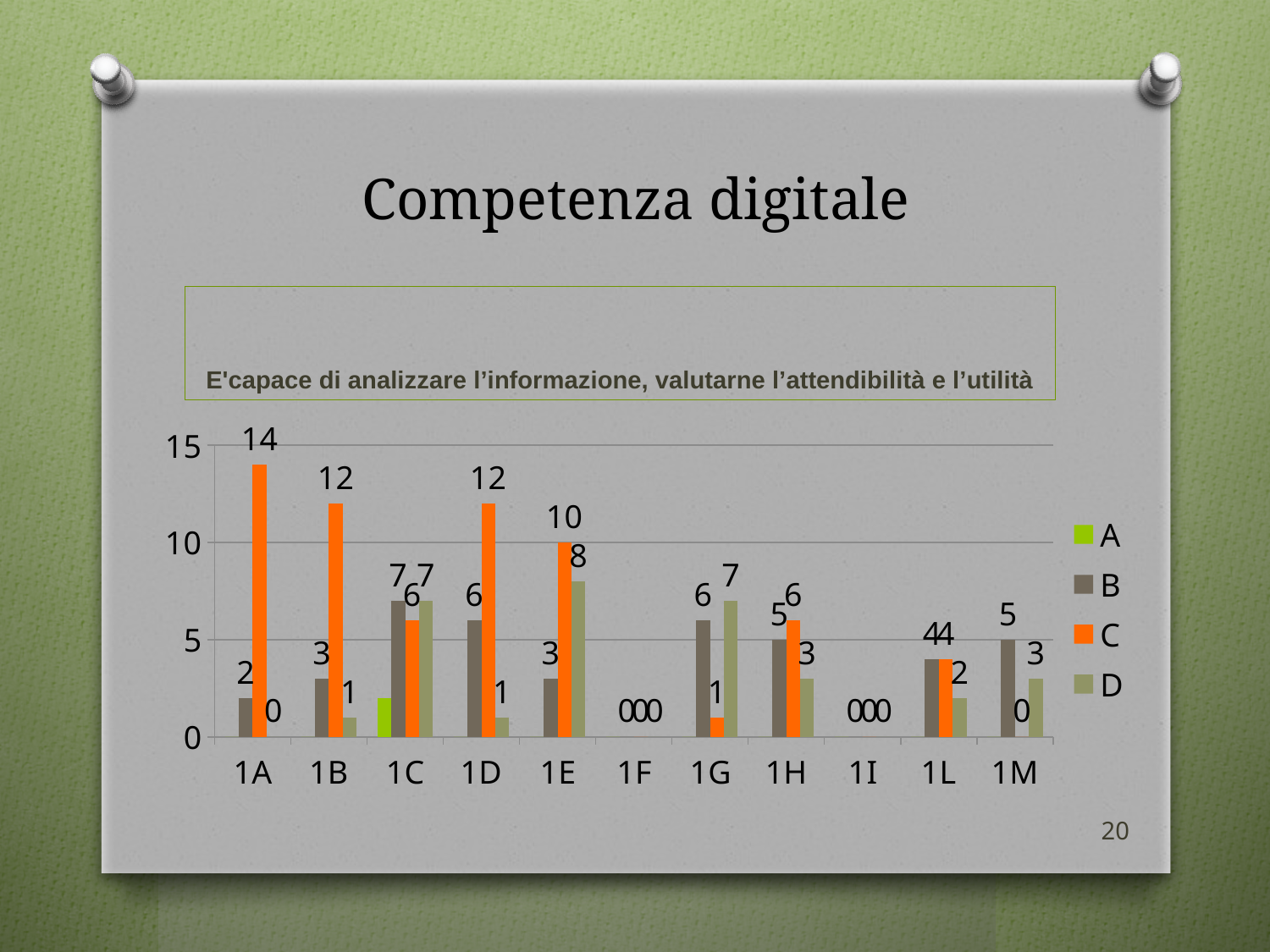
What colour represents series C in the legend? orange What is the value of series C for category 1A? 14 What kind of chart is shown on the slide? bar chart How many categories are shown on the x axis? 11 What is the value of series D for category 1E? 8 What is the value of series B for category 1M? 5 What is the value of series D for category 1H? 3 What is the difference between the series C values for 1A and 1B? 2 For category 1G, which is larger: series B or series D? D How many series does the legend list? 4 Which category has the highest value for series C? 1A Is the value of series C for category 1E greater or less than 5? greater